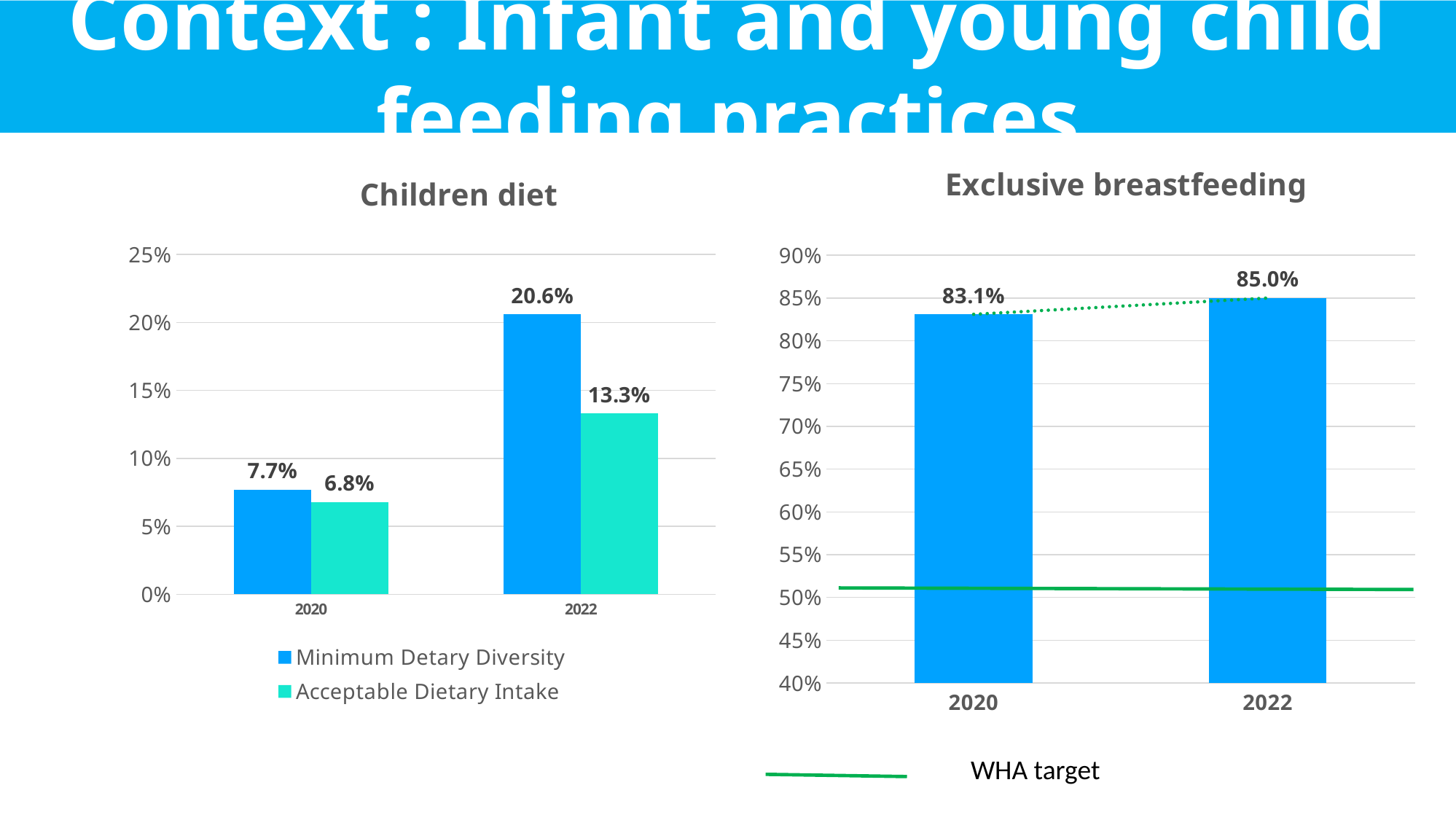
In the 'Children diet' chart, what is the value for Minimum Detary Diversity in 2022? 20.6% In the 'Children diet' chart, what is the value for Acceptable Dietary Intake in 2022? 13.3% In the 'Exclusive breastfeeding' chart, how many years are shown on the x axis? 2 In the 'Exclusive breastfeeding' chart, what is the value for 2022? 85.0% In the 'Children diet' chart, what is the difference between Minimum Detary Diversity in 2022 and in 2020? 12.9% In the 'Exclusive breastfeeding' chart, what is the difference between the 2022 and 2020 values? 1.9% In the 'Children diet' chart, which is larger in 2022: Minimum Detary Diversity or Acceptable Dietary Intake? Minimum Detary Diversity In the 'Children diet' chart, what is the value for Acceptable Dietary Intake in 2020? 6.8% In the 'Children diet' chart, does Acceptable Dietary Intake rise or fall from 2020 to 2022? rise What kind of chart is the 'Exclusive breastfeeding' chart? bar chart In the 'Exclusive breastfeeding' chart, what is the value for 2020? 83.1% In the 'Children diet' chart, how many series does the legend list? 2